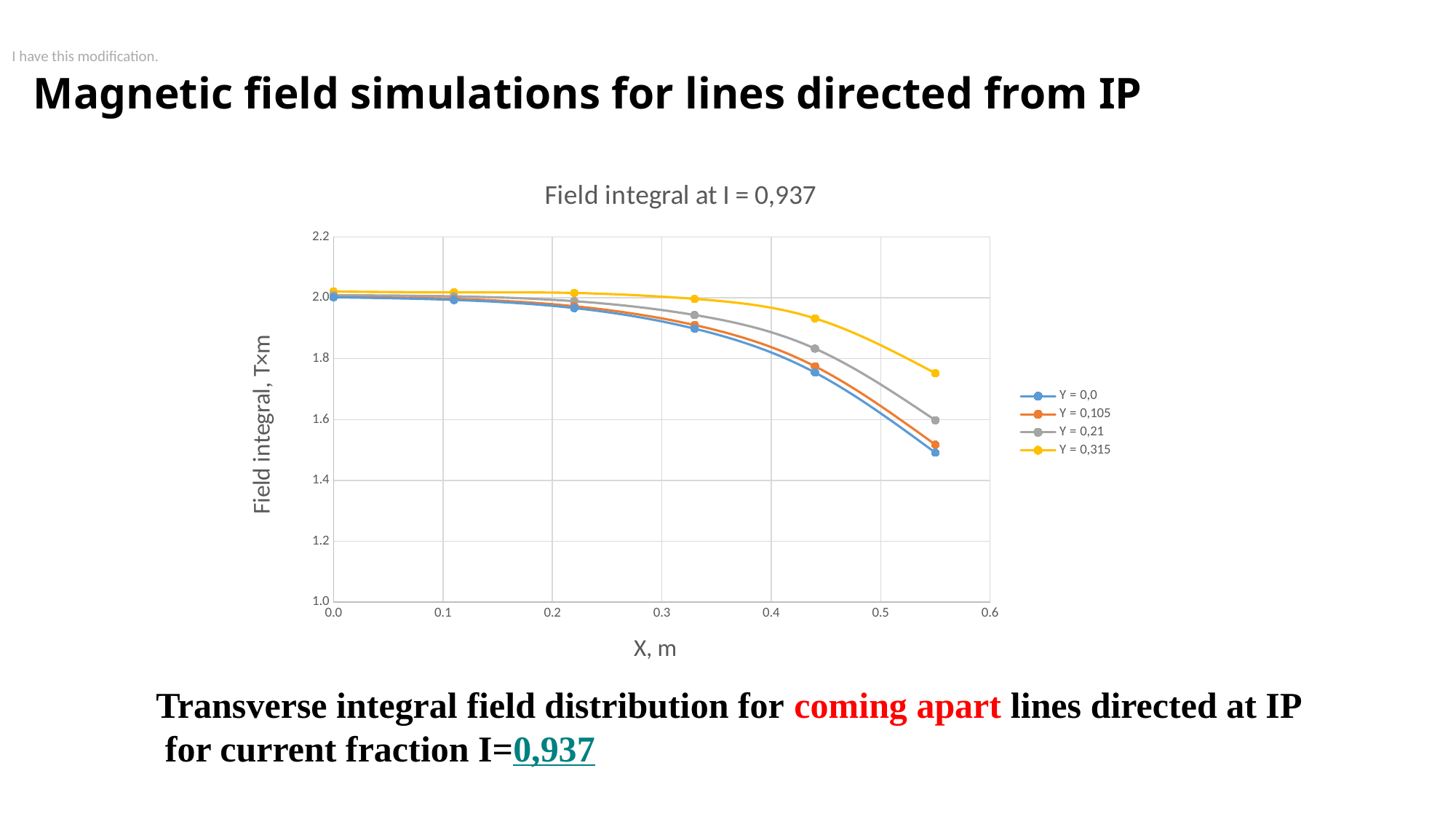
Which series has the highest value at X = 0.55? Y = 0,315 At X = 0.55, which is larger: the value for Y = 0,315 or the value for Y = 0,0? Y = 0,315 Which series has the lowest value at X = 0.55? Y = 0,0 How many data points are plotted for the Y = 0,315 series? 6 Do the values of the Y = 0,0 series rise or fall as X increases? fall What is the title of the chart? Field integral at I = 0,937 How many series does the legend list? 4 Is the value for Y = 0,0 at X = 0.44 greater or less than 1.8? less Is the value for Y = 0,315 at X = 0.55 greater or less than 1.6? greater What is the label of the y axis? Field integral, T×m Is the value for Y = 0,0 at X = 0.55 greater or less than 1.6? less What kind of chart is shown on the slide? line chart